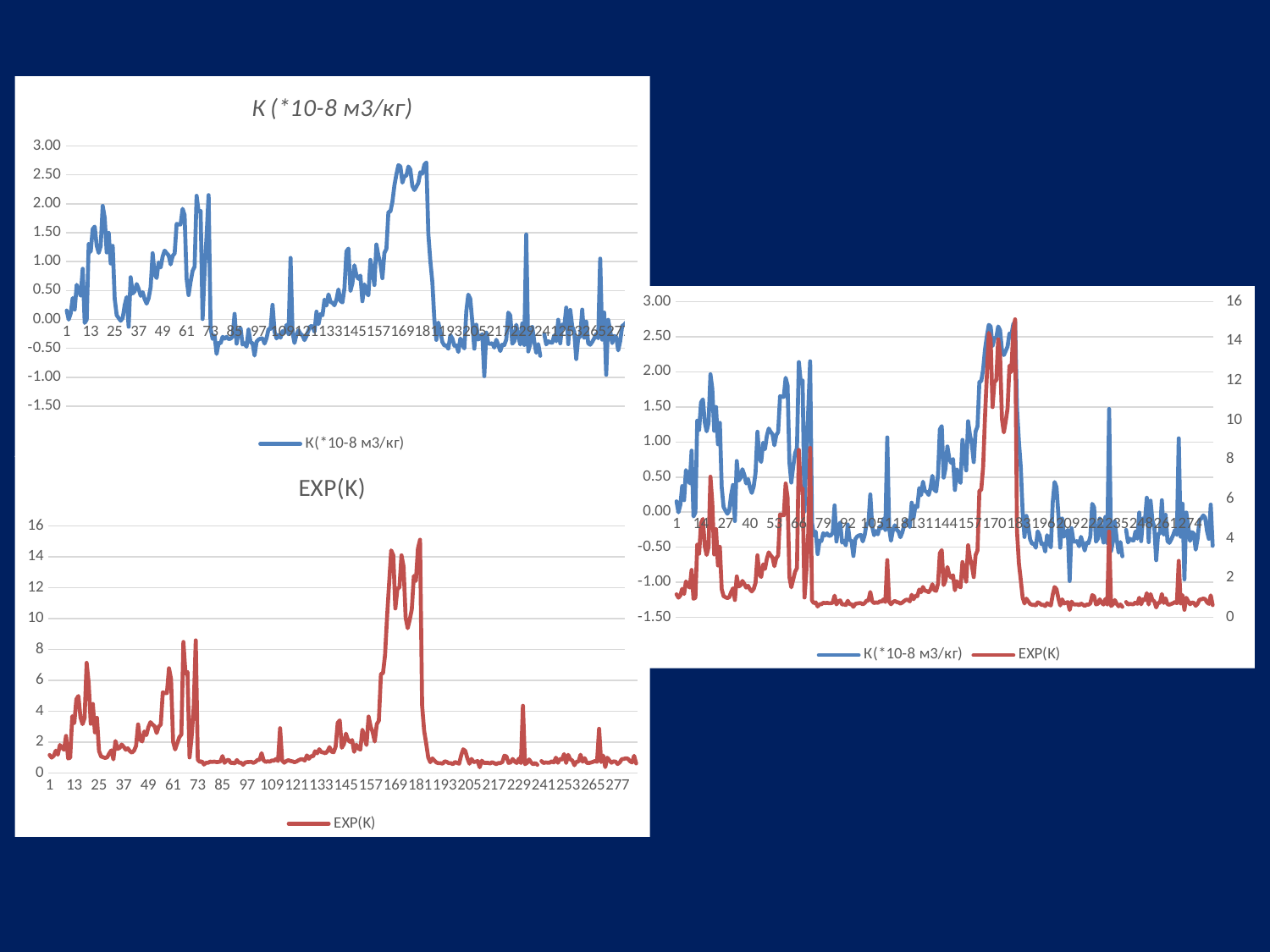
What kind of chart is the right-hand chart with the blue and red lines? line chart In the bottom-left EXP(K) chart, is the highest peak of the line greater or less than 14? greater What is the title of the bottom-left chart? EXP(K) In the top-left chart К (*10-8 м3/кг), is the value at x = 1 greater or less than 0.50? less In the right-hand chart, what is the highest tick value shown on the right-hand vertical axis? 16 In the right-hand chart, what colour is the EXP(K) line? red In the top-left chart К (*10-8 м3/кг), is the highest value of the line greater or less than 2.50? greater What kind of chart is the top-left chart titled К (*10-8 м3/кг)? line chart How many series does the legend of the right-hand chart list? 2 How many series does the legend of the bottom-left EXP(K) chart list? 1